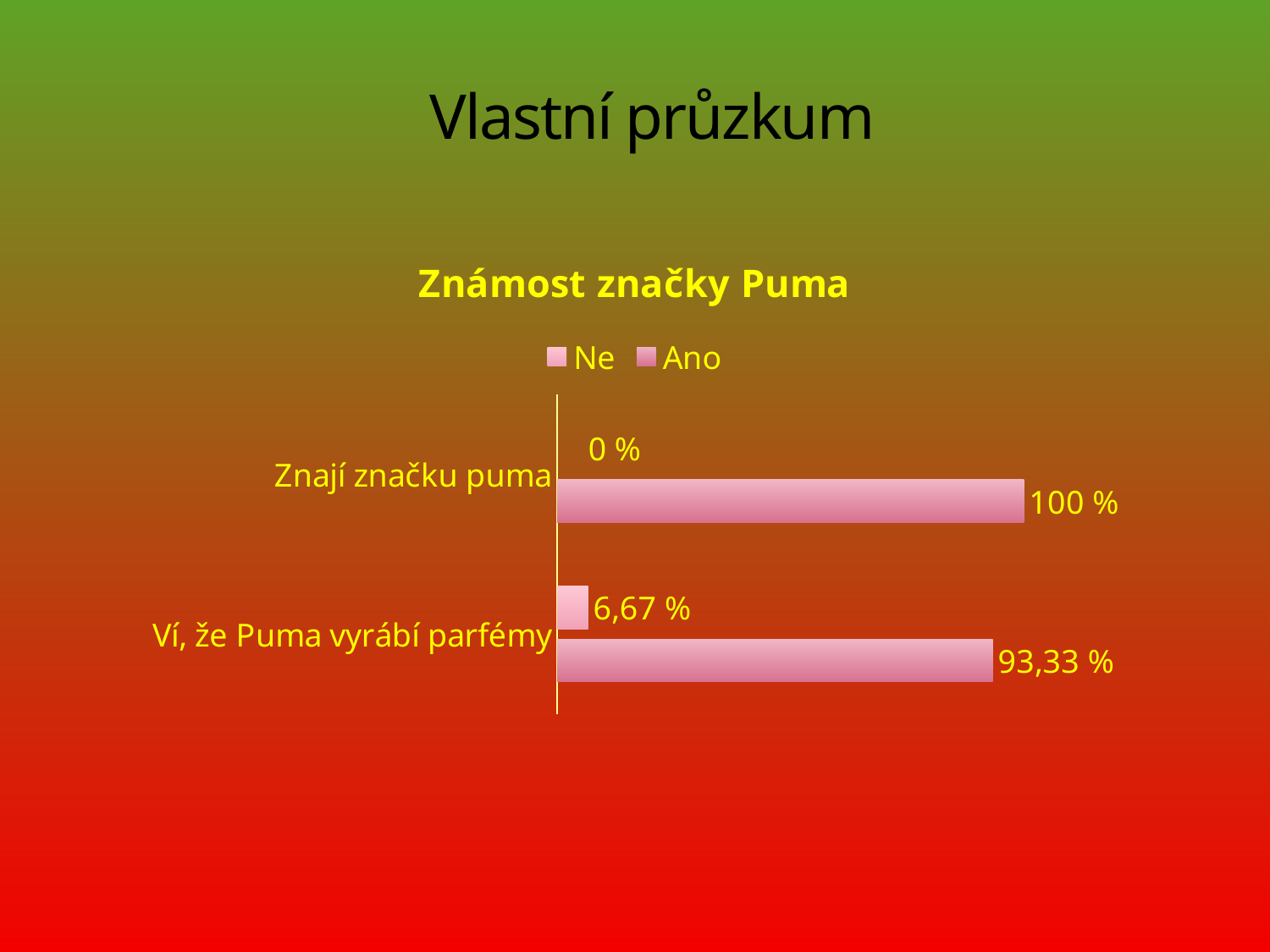
What is the title of the chart? Známost značky Puma What is the 'Ano' value for 'Znají značku puma'? 100 % What is the 'Ano' value for 'Ví, že Puma vyrábí parfémy'? 93,33 % Which category has the lower 'Ne' value? Znají značku puma Which category has the higher 'Ano' value? Znají značku puma What is the difference between the 'Ano' values for 'Znají značku puma' and 'Ví, že Puma vyrábí parfémy'? 6,67 % How many categories are shown on the chart? 2 How many series does the chart legend list? 2 What is the 'Ne' value for 'Znají značku puma'? 0 % What kind of chart is shown on the slide? bar chart What is the 'Ne' value for 'Ví, že Puma vyrábí parfémy'? 6,67 % Which is larger for 'Ví, že Puma vyrábí parfémy': the 'Ano' value or the 'Ne' value? Ano